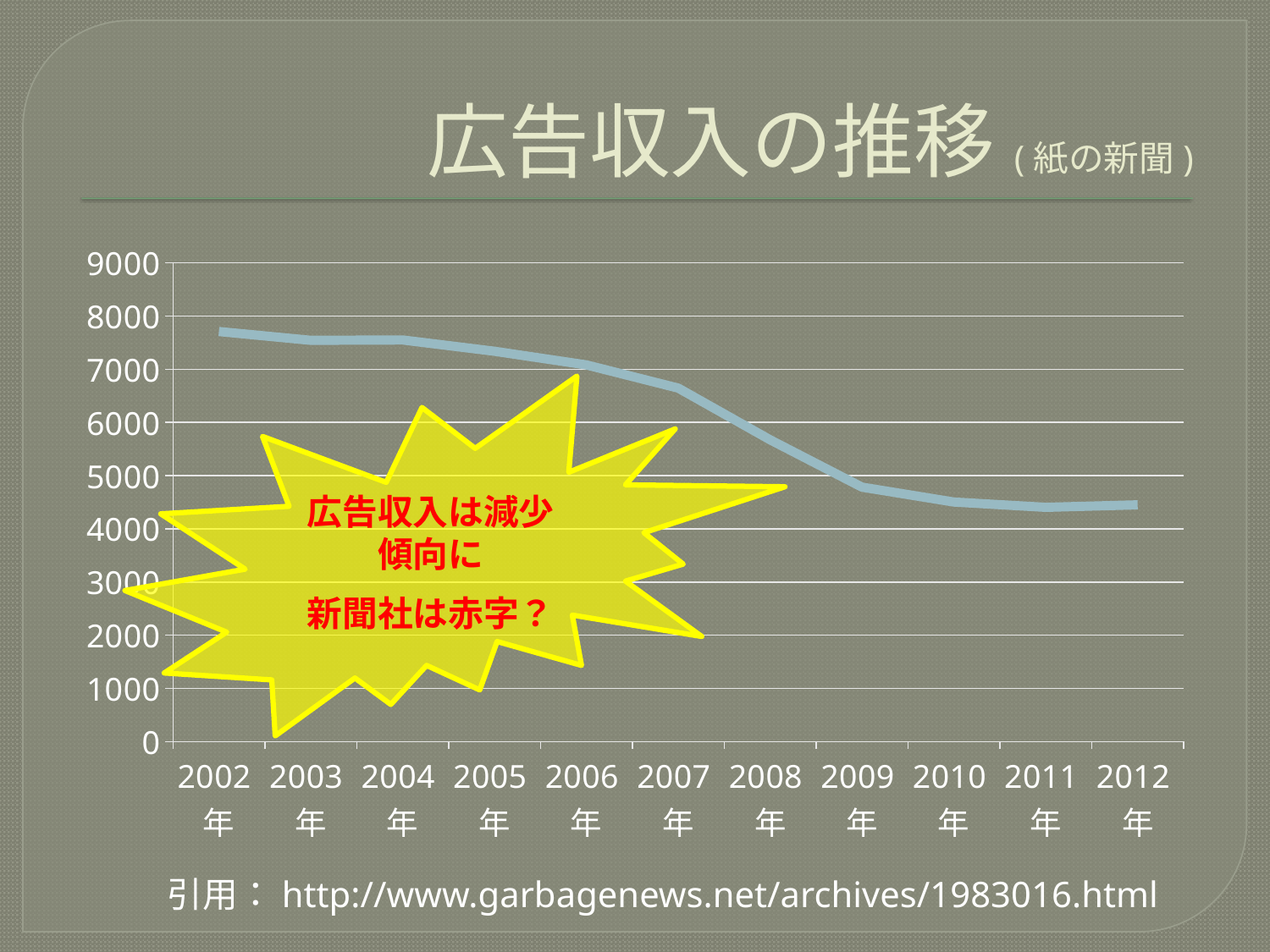
Is the value for 2007年 greater or less than 6000? greater Is the value for 2008年 greater or less than 5000? greater How many years are plotted along the x axis of the chart? 11 Do the values in the chart rise or fall from 2002 to 2012? fall Which is larger, the value for 2002年 or the value for 2012年? 2002年 What kind of chart is shown on the slide? line chart Is the value for 2009年 greater or less than 5000? less What is the highest value shown on the y axis of the chart? 9000 What is the title of the chart on the slide? 広告収入の推移 (紙の新聞) Which year has the highest value in the chart? 2002年